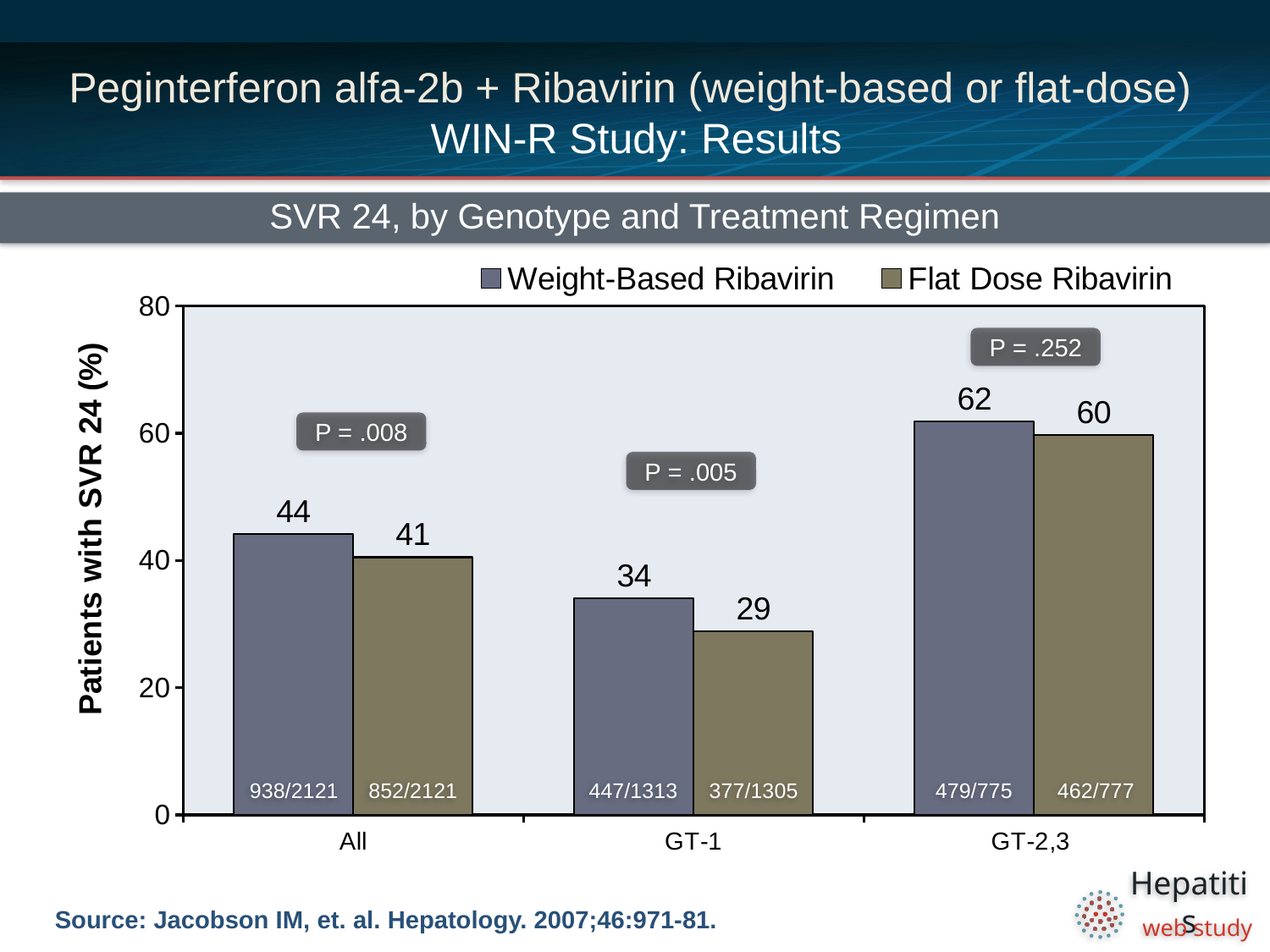
What is the difference between the Weight-Based Ribavirin and Flat Dose Ribavirin SVR 24 rates in the GT-1 group? 5 Which genotype group has the highest SVR 24 rate for Weight-Based Ribavirin? GT-2,3 How many genotype groups are shown on the x axis? 3 Which genotype group has the lowest SVR 24 rate for Flat Dose Ribavirin? GT-1 What is the P value shown for the GT-2,3 group? P = .252 What is the SVR 24 rate for Flat Dose Ribavirin in the All group? 41 What is the label of the y axis? Patients with SVR 24 (%) What is the SVR 24 rate for Weight-Based Ribavirin in the GT-1 group? 34 In the All group, which regimen has the higher SVR 24 rate, Weight-Based Ribavirin or Flat Dose Ribavirin? Weight-Based Ribavirin What is the SVR 24 rate for Flat Dose Ribavirin in the GT-2,3 group? 60 How many series does the legend list? 2 What kind of chart is shown on the slide? Bar chart